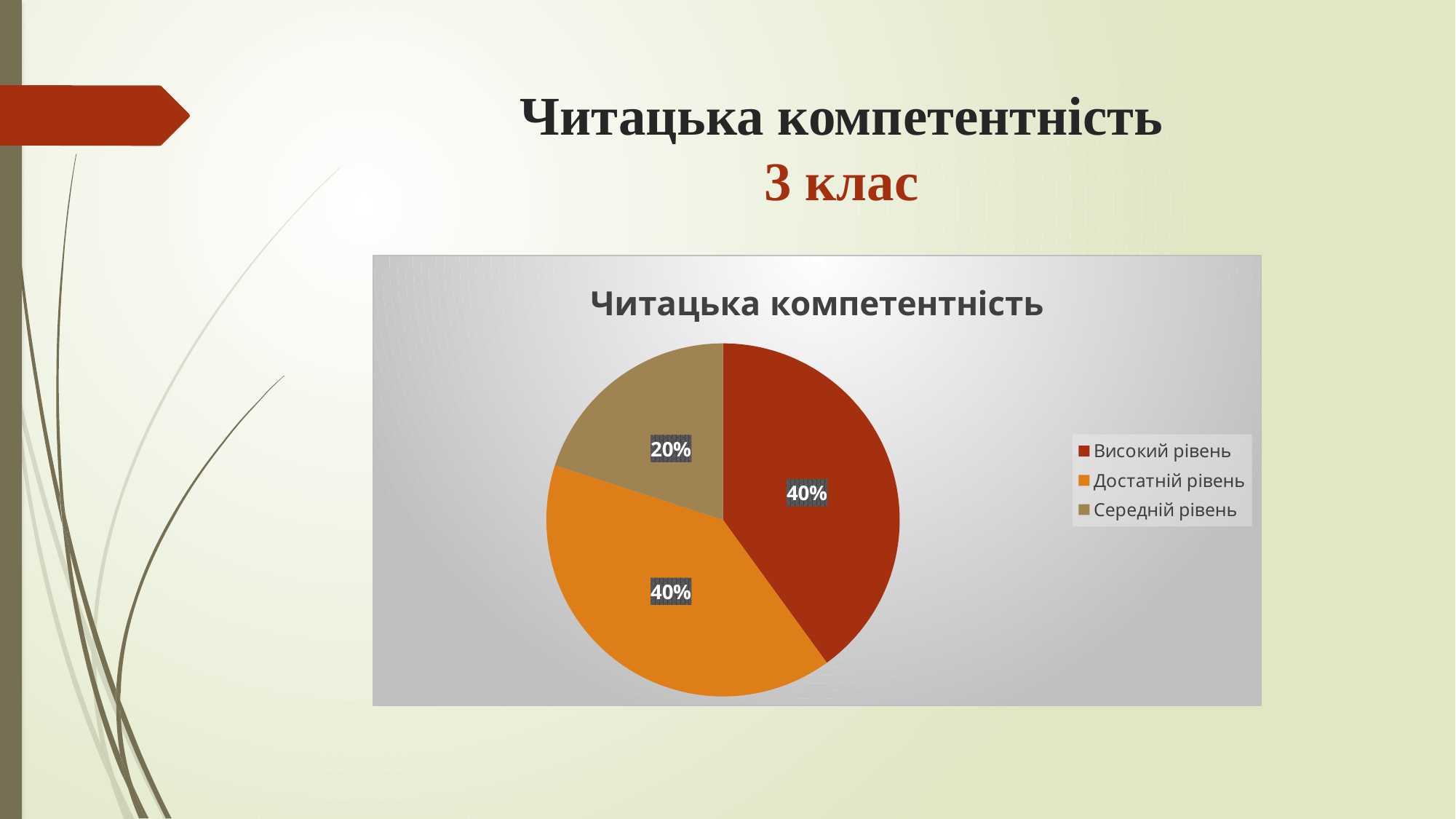
What share of the pie does Середній рівень represent? 20% What kind of chart is shown on the slide? Pie chart Do Високий рівень and Достатній рівень have the same share of the pie? Yes How many slices does the pie chart have? 3 What is the title of the chart? Читацька компетентність How many entries does the legend list? 3 What share of the pie does Достатній рівень represent? 40% Which category has the smallest slice of the pie? Середній рівень Which is larger: the slice for Високий рівень or the slice for Середній рівень? Високий рівень What share of the pie does Високий рівень represent? 40% Which category is shown in the dark red colour? Високий рівень By how many percentage points does Достатній рівень exceed Середній рівень? 20